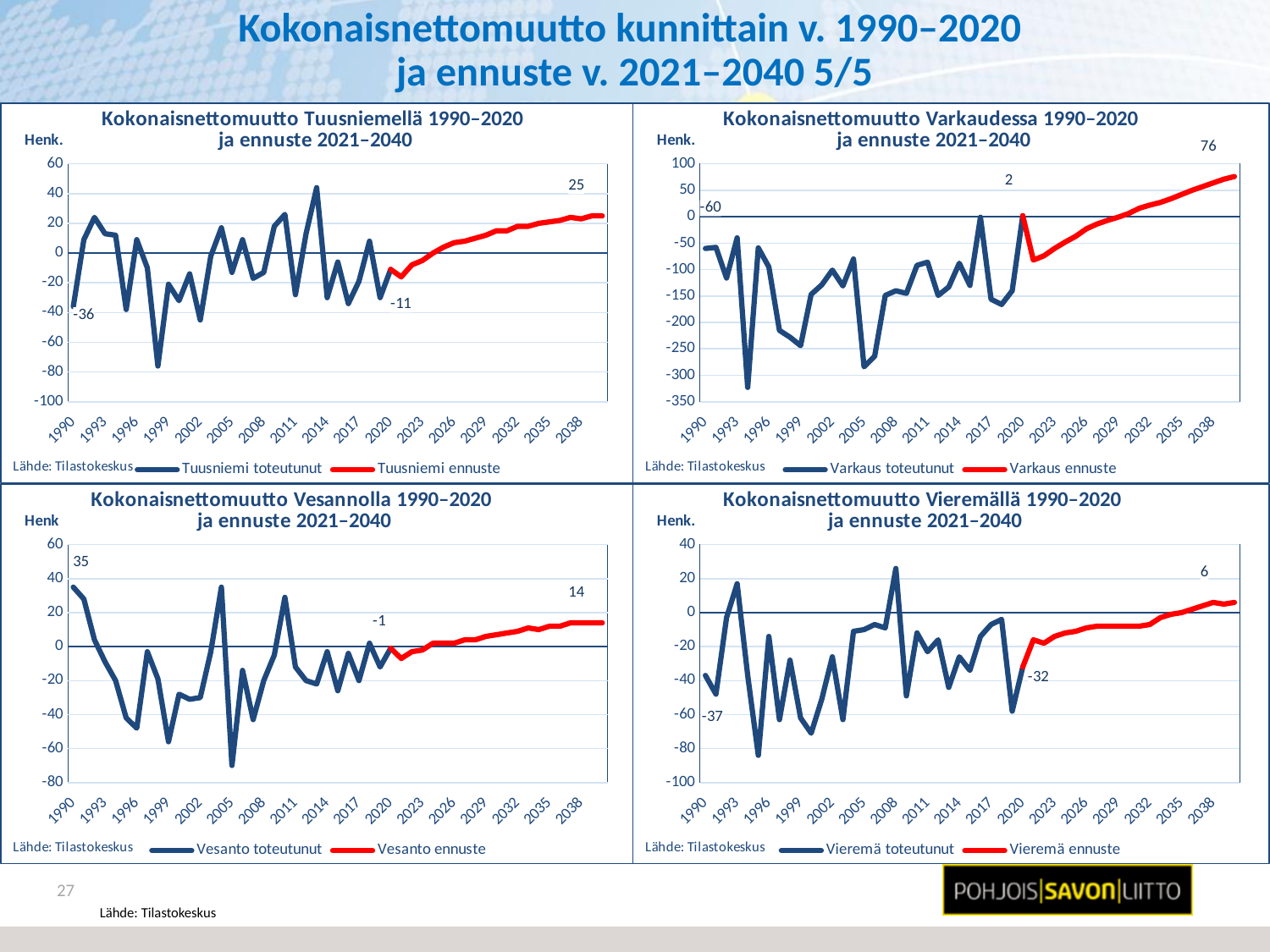
In the Vesanto chart (bottom left), what is the labelled value for 1990? 35 In the Varkaus chart (top right), what is the labelled value for 2020? 2 In the Vesanto chart (bottom left), does the forecast line rise or fall from 2021 to 2040? rise In the Vieremä chart (bottom right), which is larger, the value for 1990 or the value for 2020? 2020 How many series does the legend of the Varkaus chart (top right) list? 2 In the Tuusniemi chart (top left), what is the labelled forecast value for 2040? 25 In the Tuusniemi chart (top left), what is the labelled value for 1990? -36 In the Vieremä chart (bottom right), what is the labelled value for 2020? -32 In the Varkaus chart (top right), what is the difference between the 2040 forecast value and the 1990 value? 136 In the Varkaus chart (top right), what is the labelled forecast value for 2040? 76 What type of chart is the Tuusniemi chart (top left)? line chart In the Vesanto chart (bottom left), what colour is the 'Vesanto ennuste' line? red